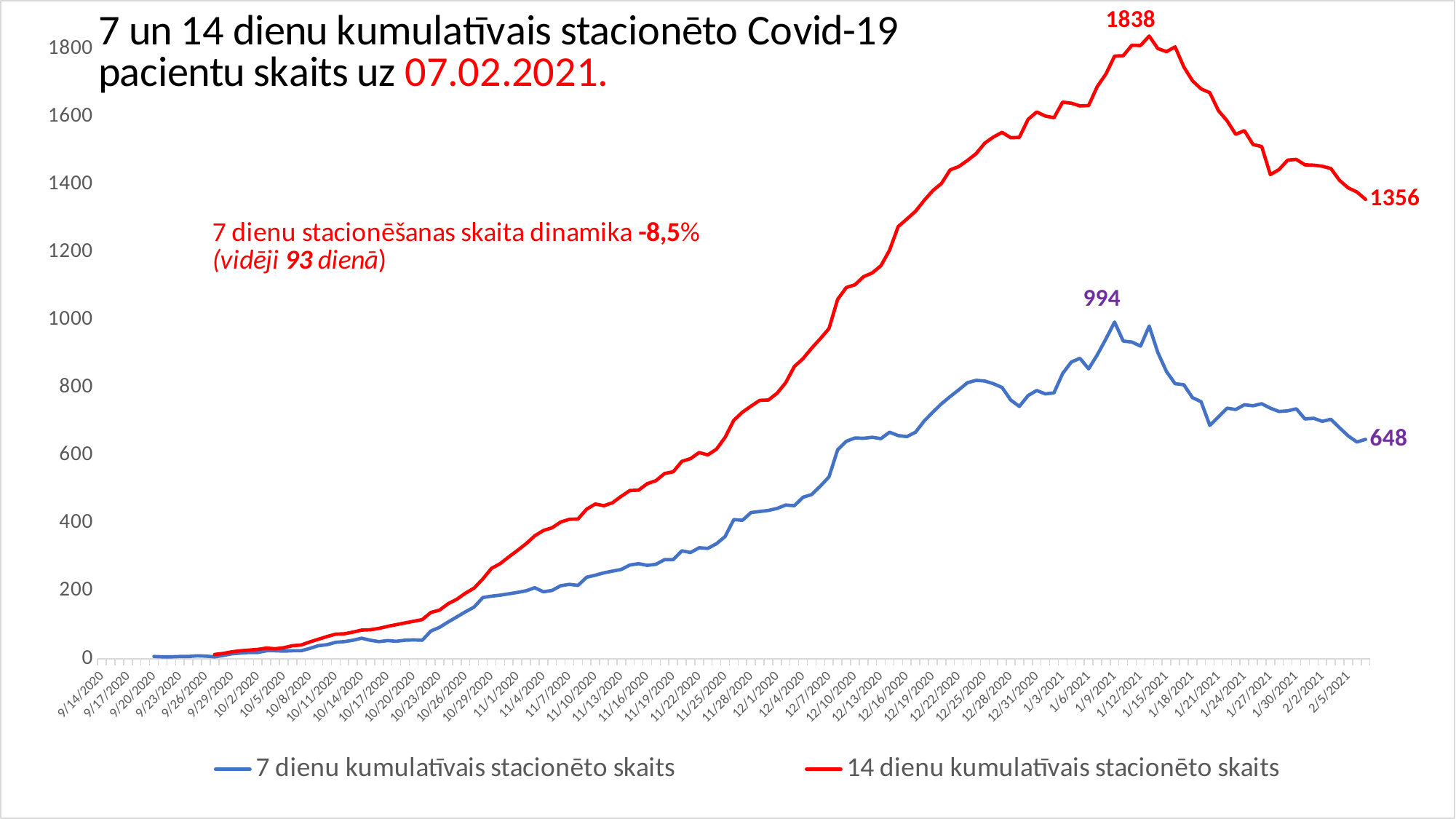
Do the values of the 14 dienu kumulatīvais stacionēto skaits line rise or fall between 1/12/2021 and 2/5/2021? fall Is the value of the 7 dienu kumulatīvais stacionēto skaits line on 12/25/2020 greater or less than 600? greater What is the peak value labelled on the 14 dienu kumulatīvais stacionēto skaits line? 1838 What is the difference between the peak (994) and the final value (648) of the 7 dienu kumulatīvais stacionēto skaits line? 346 What is the final value labelled on the 7 dienu kumulatīvais stacionēto skaits line? 648 What is the peak value labelled on the 7 dienu kumulatīvais stacionēto skaits line? 994 What is the difference between the peak (1838) and the final value (1356) of the 14 dienu kumulatīvais stacionēto skaits line? 482 What kind of chart is shown on the slide? line chart What colour is the 7 dienu kumulatīvais stacionēto skaits line? blue What is the final value labelled on the 14 dienu kumulatīvais stacionēto skaits line? 1356 How many series does the legend list? 2 Which series reaches a higher peak value, 7 dienu kumulatīvais stacionēto skaits or 14 dienu kumulatīvais stacionēto skaits? 14 dienu kumulatīvais stacionēto skaits